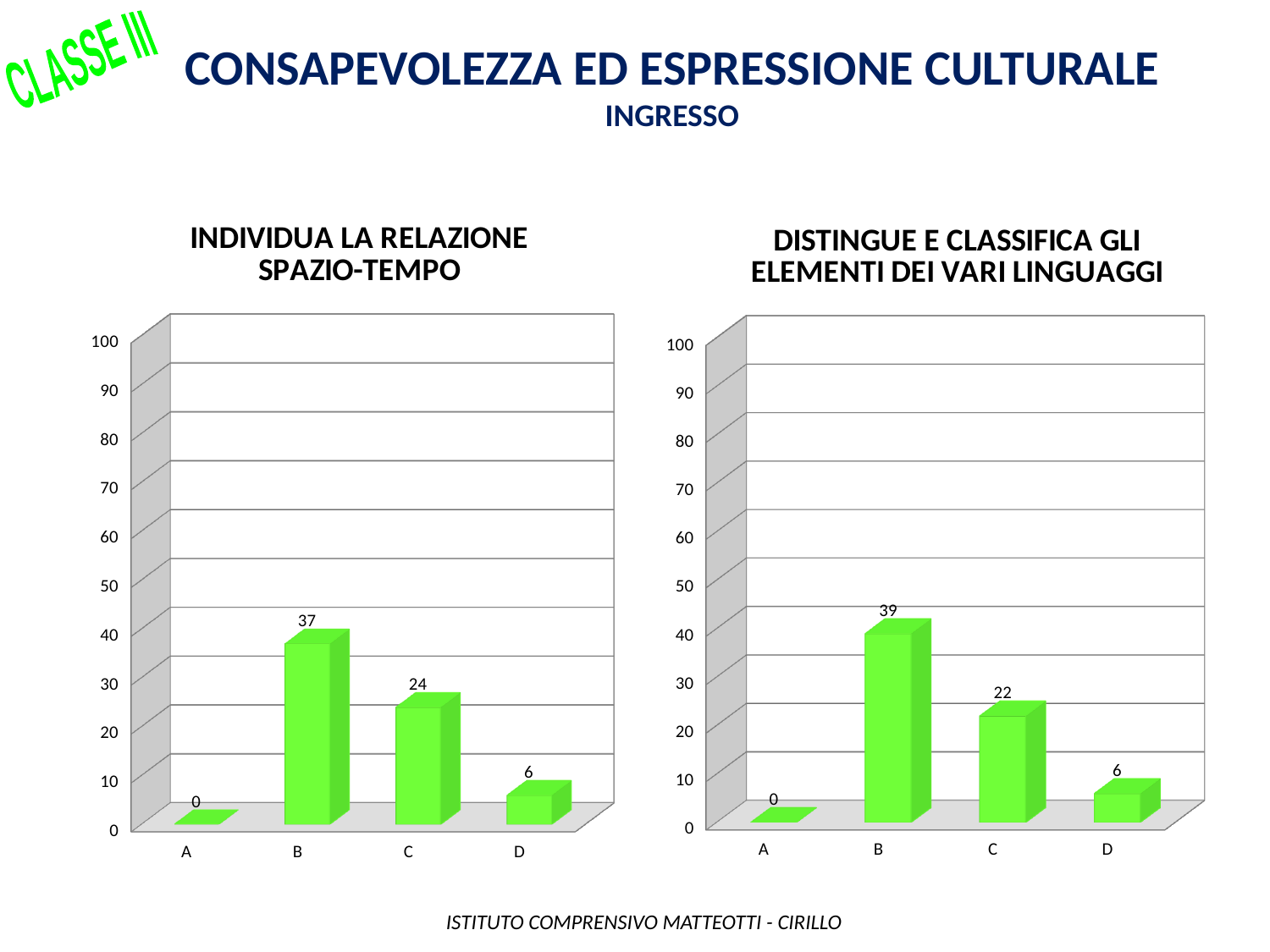
In the chart titled 'DISTINGUE E CLASSIFICA GLI ELEMENTI DEI VARI LINGUAGGI', what is the value for category B? 39 In the chart titled 'DISTINGUE E CLASSIFICA GLI ELEMENTI DEI VARI LINGUAGGI', what is the difference between the values for B and C? 17 What kind of chart is the chart titled 'DISTINGUE E CLASSIFICA GLI ELEMENTI DEI VARI LINGUAGGI'? Bar chart In the chart titled 'INDIVIDUA LA RELAZIONE SPAZIO-TEMPO', what is the value for category B? 37 In the chart titled 'INDIVIDUA LA RELAZIONE SPAZIO-TEMPO', what is the difference between the values for B and C? 13 How many categories are shown in the chart titled 'INDIVIDUA LA RELAZIONE SPAZIO-TEMPO'? 4 In the chart titled 'DISTINGUE E CLASSIFICA GLI ELEMENTI DEI VARI LINGUAGGI', what is the value for category D? 6 In the chart titled 'INDIVIDUA LA RELAZIONE SPAZIO-TEMPO', is the value for B greater or less than 50? less In the chart titled 'INDIVIDUA LA RELAZIONE SPAZIO-TEMPO', what is the value for category C? 24 In the chart titled 'DISTINGUE E CLASSIFICA GLI ELEMENTI DEI VARI LINGUAGGI', which category has the lowest value? A In the chart titled 'INDIVIDUA LA RELAZIONE SPAZIO-TEMPO', which category has the highest value? B In the chart titled 'DISTINGUE E CLASSIFICA GLI ELEMENTI DEI VARI LINGUAGGI', which is larger, the value for C or the value for D? C